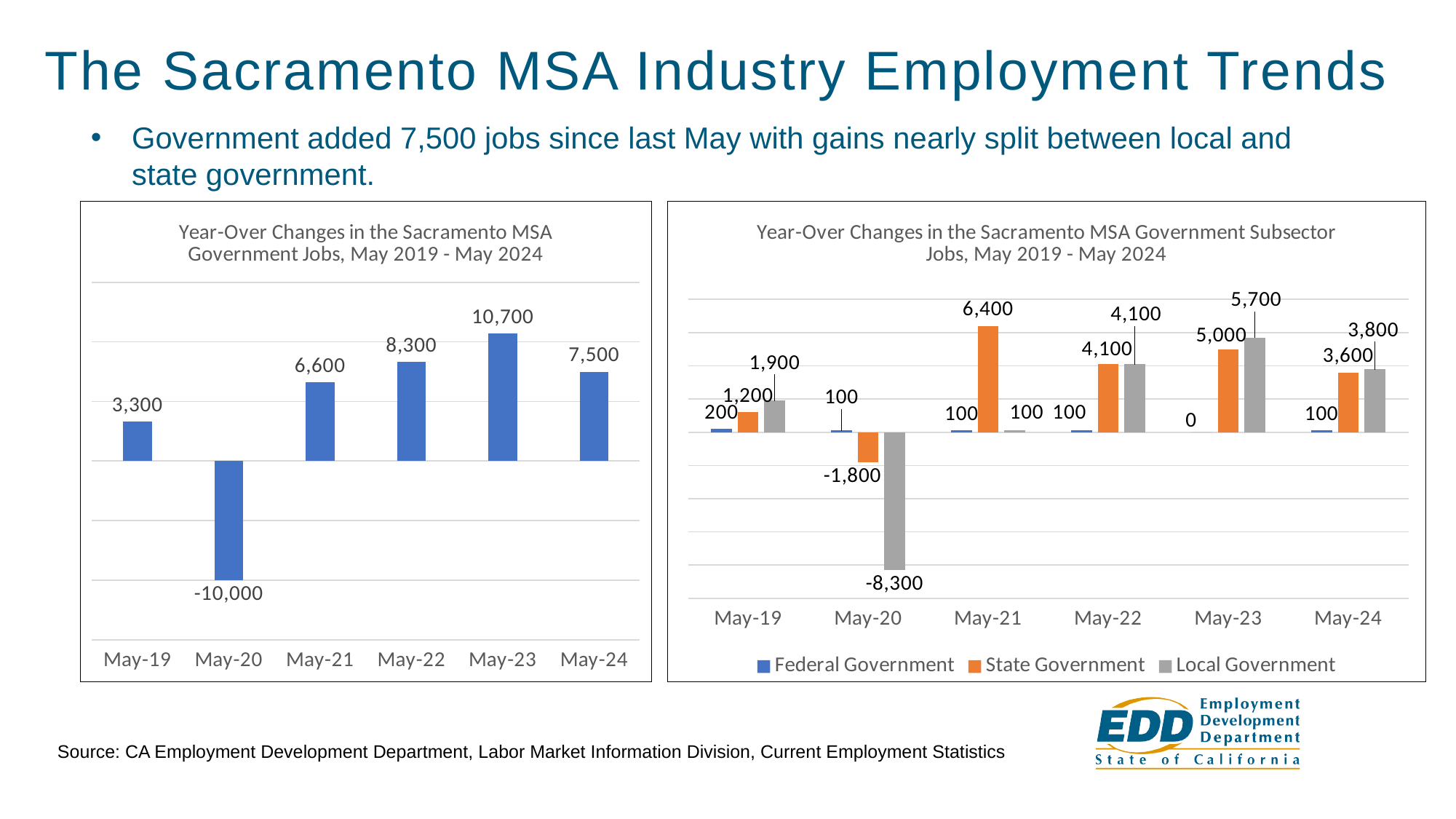
In the left chart, Year-Over Changes in the Sacramento MSA Government Jobs, which period has the highest value? May-23 In the left chart, Year-Over Changes in the Sacramento MSA Government Jobs, what is the difference between the May-23 and May-24 values? 3,200 In the left chart, Year-Over Changes in the Sacramento MSA Government Jobs, how many periods are shown on the x axis? 6 In the right chart, Year-Over Changes in the Sacramento MSA Government Subsector Jobs, which is larger in May-24: State Government or Local Government? Local Government In the left chart, Year-Over Changes in the Sacramento MSA Government Jobs, what is the value for May-24? 7,500 In the right chart, Year-Over Changes in the Sacramento MSA Government Subsector Jobs, what is the difference between Local Government and State Government in May-23? 700 In the right chart, Year-Over Changes in the Sacramento MSA Government Subsector Jobs, how many series does the legend list? 3 In the left chart, Year-Over Changes in the Sacramento MSA Government Jobs, which period has the lowest value? May-20 In the right chart, Year-Over Changes in the Sacramento MSA Government Subsector Jobs, what is the value for State Government in May-21? 6,400 What kind of chart is the left chart, Year-Over Changes in the Sacramento MSA Government Jobs? Bar chart In the right chart, Year-Over Changes in the Sacramento MSA Government Subsector Jobs, what is the value for Local Government in May-20? -8,300 In the right chart, Year-Over Changes in the Sacramento MSA Government Subsector Jobs, which colour represents State Government? Orange